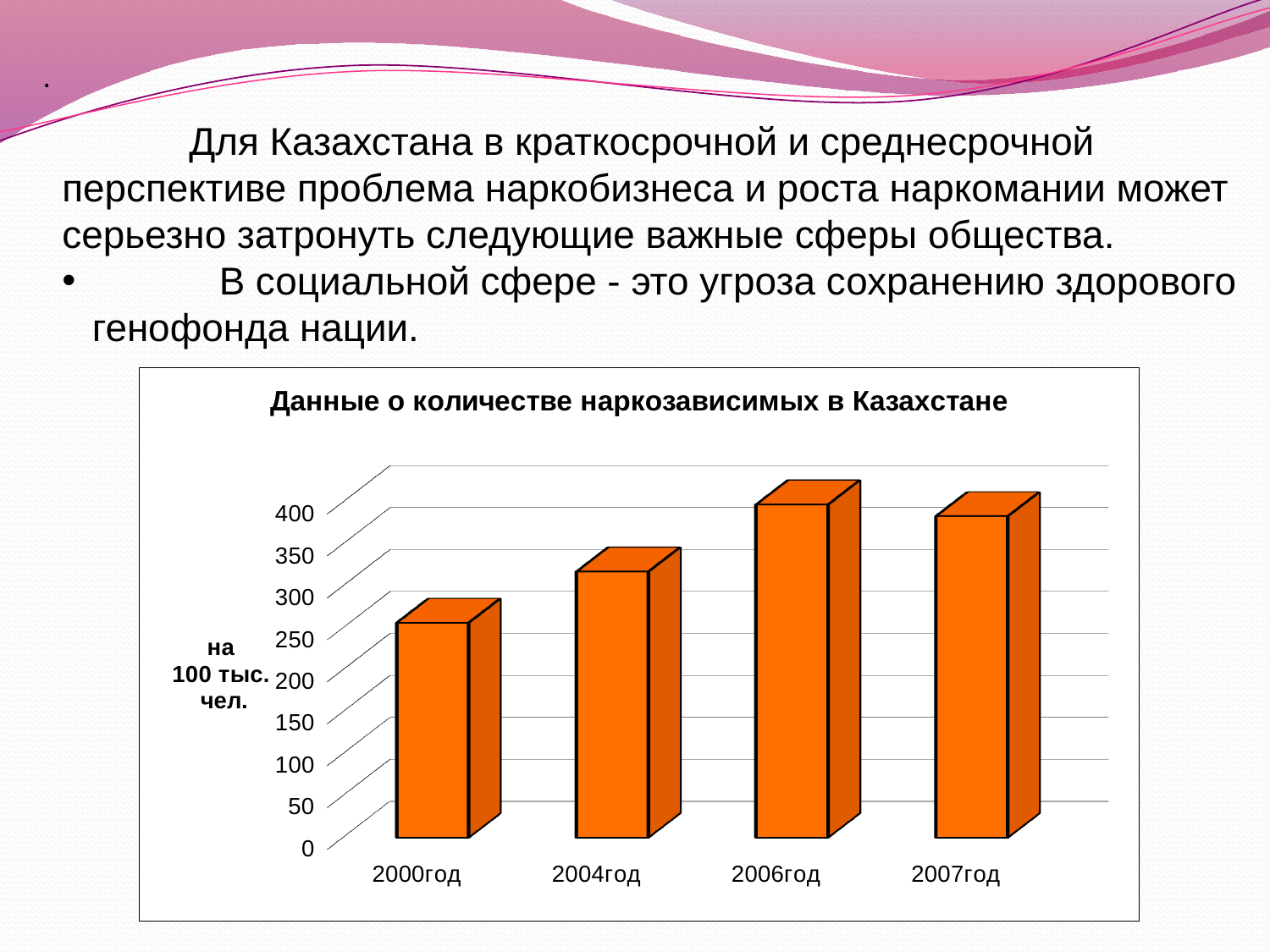
Is the value for 2004год greater or less than 300? greater Is the value for 2007год greater or less than 350? greater Which is larger, the value for 2000год or the value for 2004год? 2004год Is the value for 2000год greater or less than 200? greater Which year has the highest bar in the chart? 2006год What is the title of the chart? Данные о количестве наркозависимых в Казахстане Which year has the lowest bar in the chart? 2000год What kind of chart is shown on the slide? bar chart How many categories (years) are shown on the x axis of the chart? 4 Do the values rise or fall from 2000год to 2006год? rise